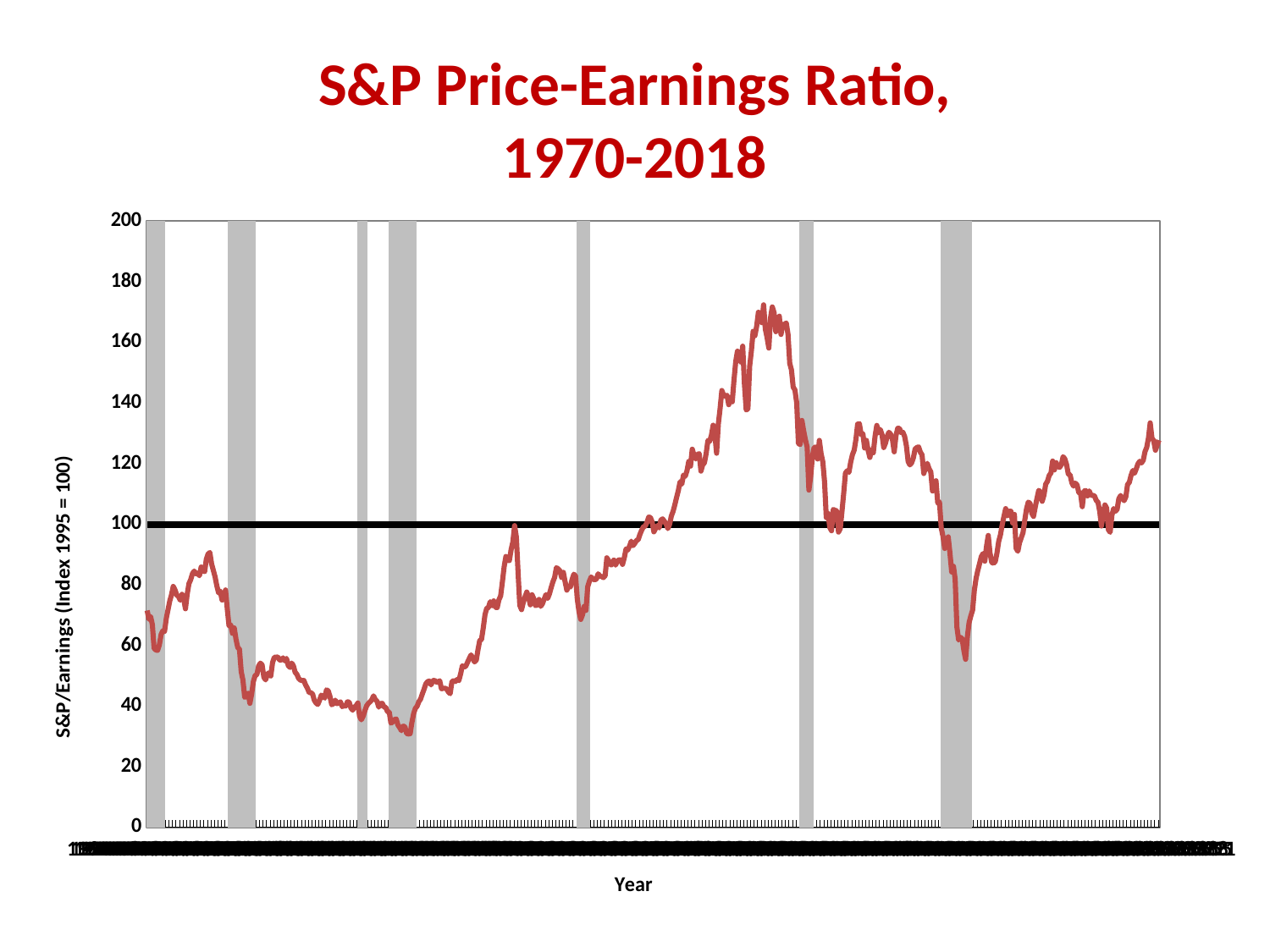
At the left end of the chart, is the red line greater or less than 100? less Is the lowest point reached by the red line greater or less than 40? less Is the highest point reached by the red line greater or less than 160? greater At what value on the y axis is the thick black horizontal reference line drawn? 100 How many grey shaded vertical bands are drawn on the chart? 7 What kind of chart is shown on the slide? line chart Comparing the start of the line to its end, does the S&P price-earnings ratio rise or fall overall across the chart? rise What is the title of the chart? S&P Price-Earnings Ratio, 1970-2018 What is the maximum value shown on the y axis? 200